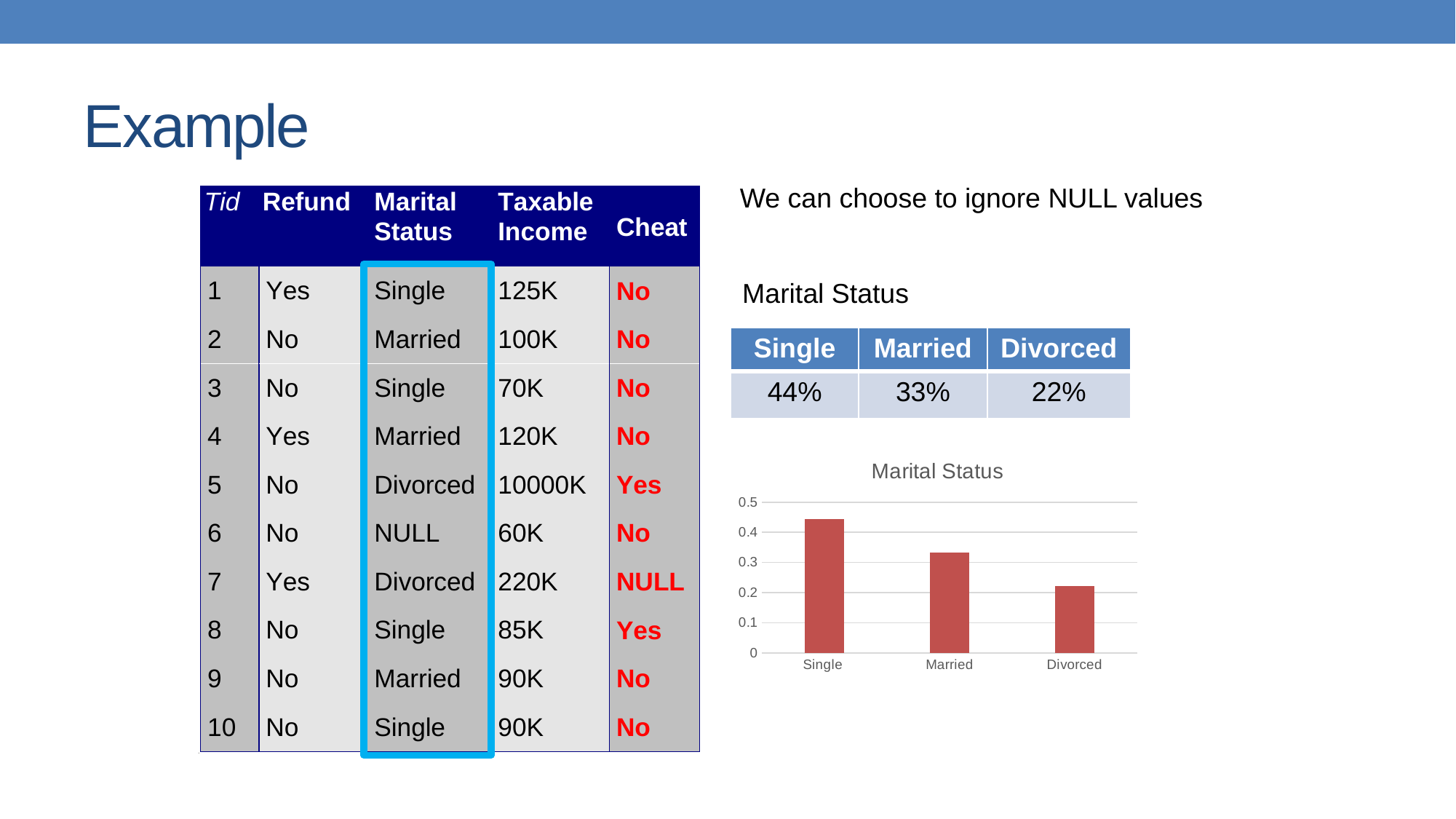
Which is larger in the chart, the bar for Married or the bar for Divorced? Married What is the title of the chart? Marital Status Which category has the lowest bar in the chart? Divorced Is the value for Married greater or less than 0.4? less Is the value for Single greater or less than 0.4? greater Is the value for Divorced greater or less than 0.3? less Do the bar values rise or fall from left to right across the x axis? fall What is the highest tick value shown on the chart's vertical axis? 0.5 Which category has the highest bar in the chart? Single How many categories are shown on the x axis of the chart? 3 What kind of chart is shown on the slide? bar chart